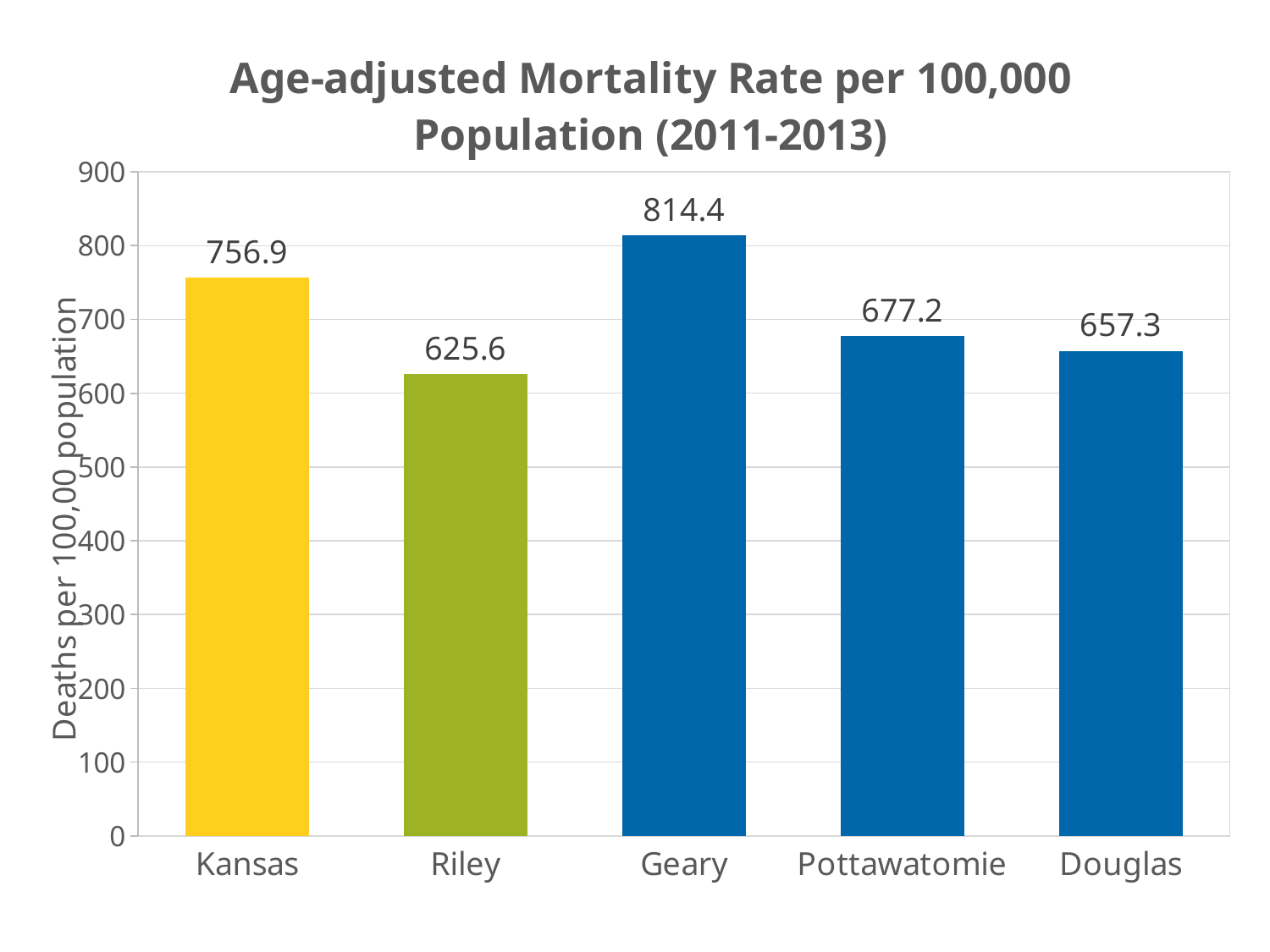
What is the difference between the mortality rates of Kansas and Douglas? 99.6 What is the age-adjusted mortality rate for Pottawatomie? 677.2 Which has a higher mortality rate, Pottawatomie or Douglas? Pottawatomie Is the value for Geary greater or less than 800? greater Which category has the highest mortality rate? Geary What is the age-adjusted mortality rate for Kansas? 756.9 What is the age-adjusted mortality rate for Riley? 625.6 What kind of chart is shown on the slide? Bar chart Which category has the lowest mortality rate? Riley How many categories are shown on the x axis? 5 What is the label of the vertical axis? Deaths per 100,00 population What is the difference between the mortality rates of Geary and Riley? 188.8